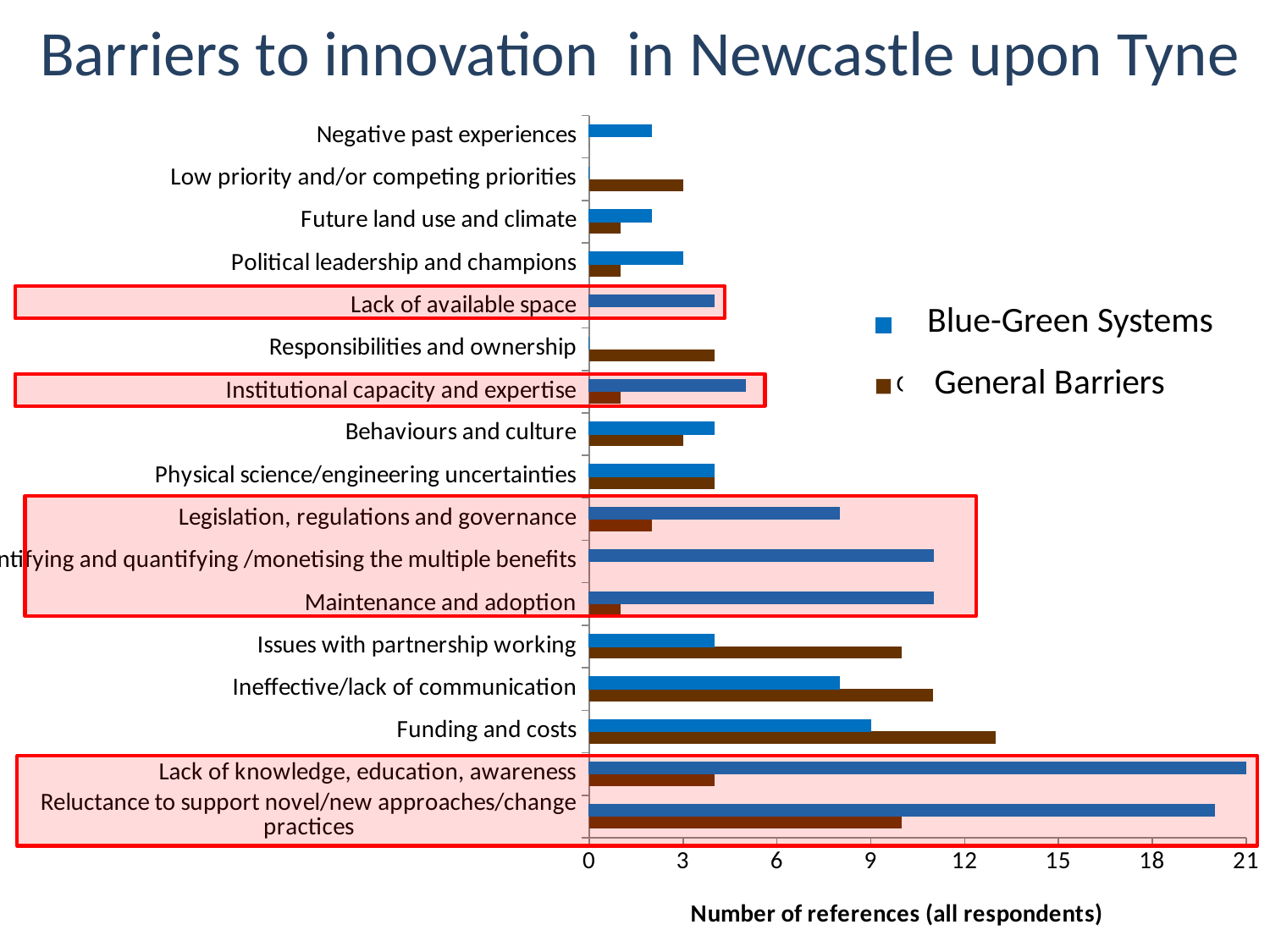
What is the Blue-Green Systems value for Funding and costs? 9 What kind of chart is shown on the slide? bar chart How many barrier categories are plotted on the chart? 17 Which category has the highest General Barriers value? Funding and costs What is the Blue-Green Systems value for Lack of knowledge, education, awareness? 21 Is the General Barriers value for Funding and costs greater or less than 12? greater Which category has the highest Blue-Green Systems value? Lack of knowledge, education, awareness Is the Blue-Green Systems value for Legislation, regulations and governance greater or less than 9? less What is the General Barriers value for Low priority and/or competing priorities? 3 For Funding and costs, which series has the larger value, Blue-Green Systems or General Barriers? General Barriers How many series does the legend list? 2 What is the title of the horizontal axis? Number of references (all respondents)